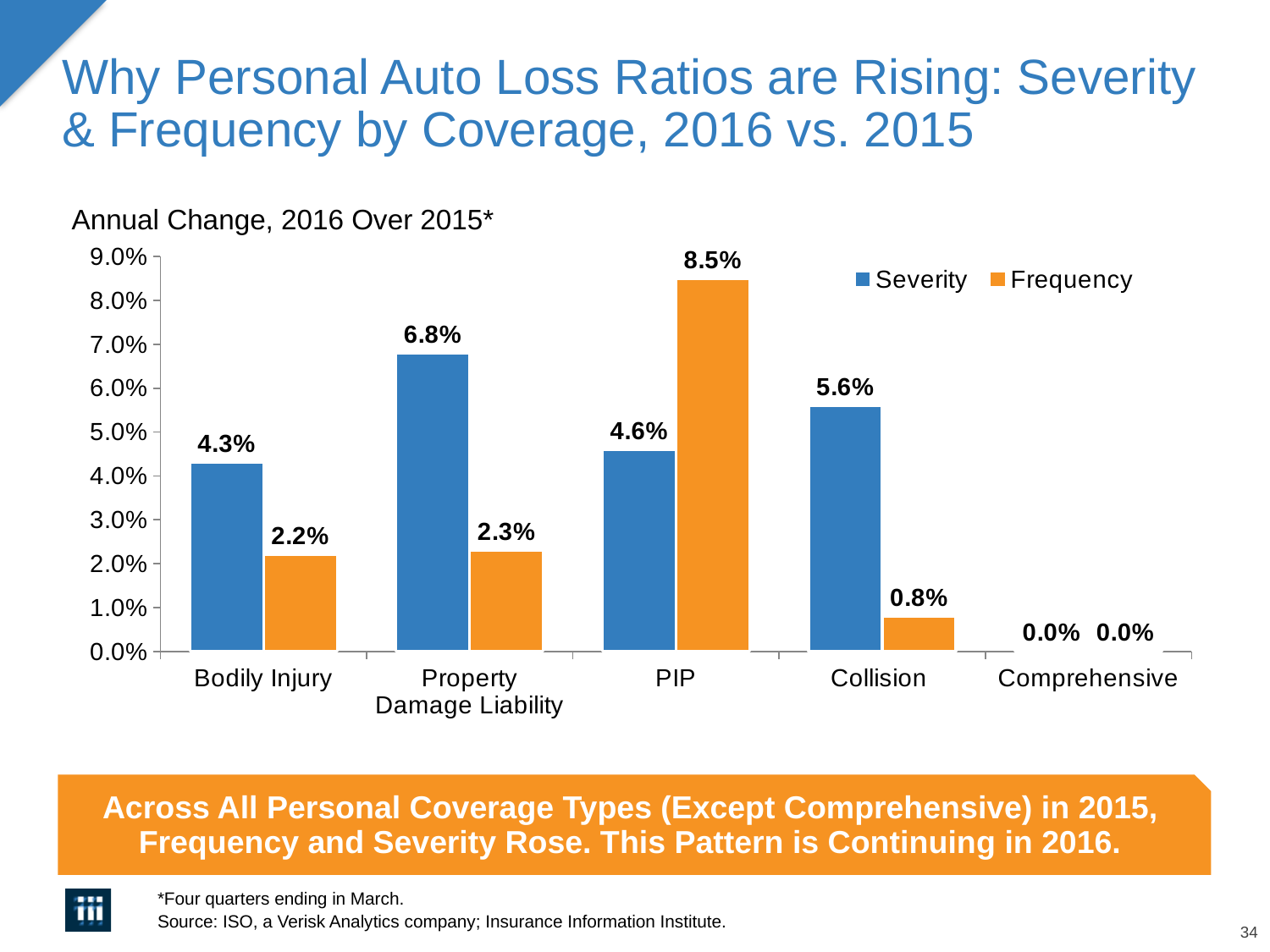
What kind of chart is shown on the slide? Bar chart What is the Frequency value for PIP? 8.5% What is the Frequency value for Collision? 0.8% How many coverage categories are shown on the x axis? 5 Which coverage has the highest Frequency value? PIP What is the Severity value for Property Damage Liability? 6.8% What is the Severity value for Bodily Injury? 4.3% What is the difference between the Frequency and Severity values for PIP? 3.9% What colour represents the Frequency series? Orange How many series does the legend list? 2 Which coverage has the highest Severity value? Property Damage Liability Which is larger for Collision, Severity or Frequency? Severity